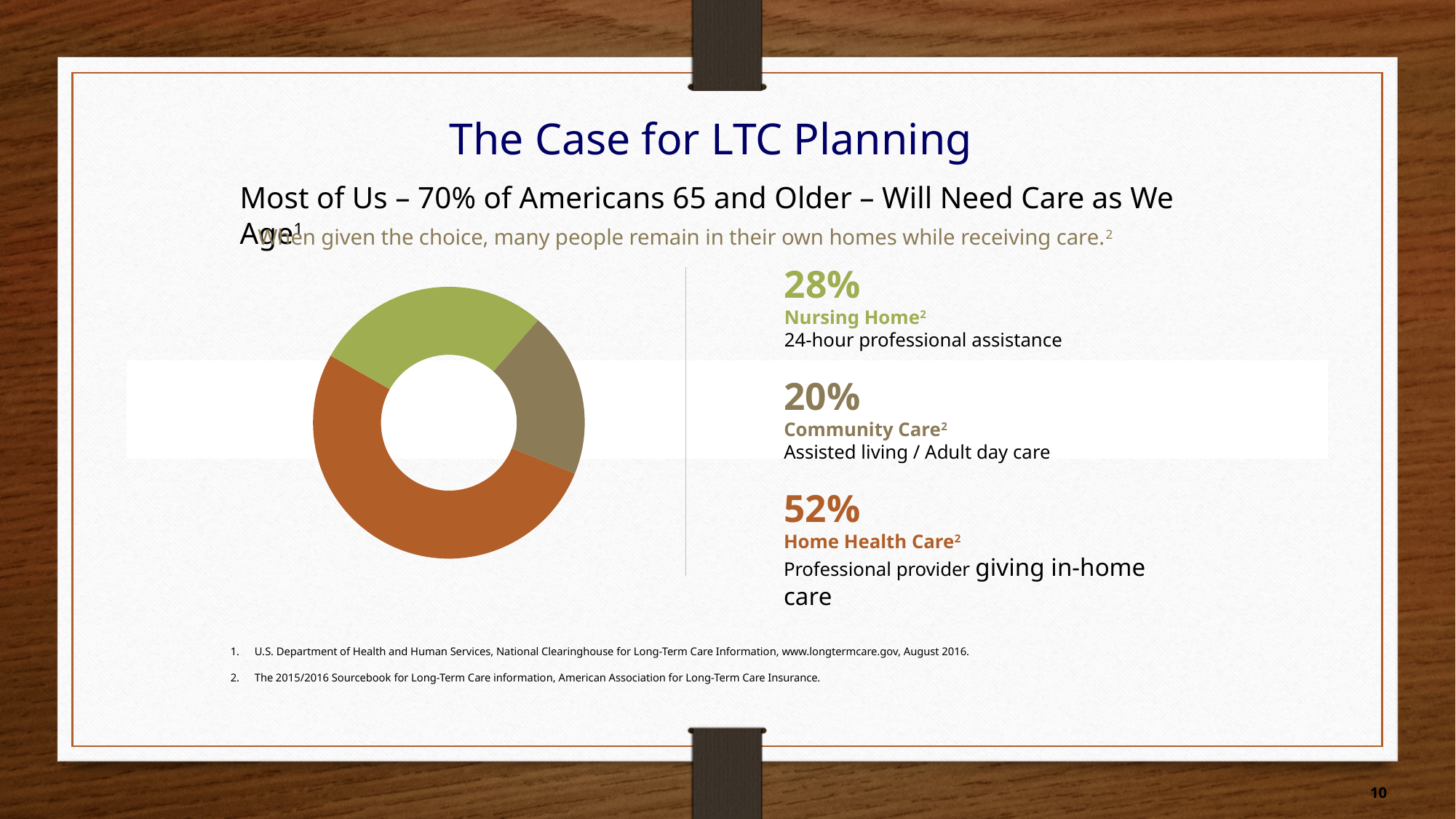
Which colour represents Home Health Care in the chart? Orange What percentage is shown for Nursing Home? 28% Which colour represents Nursing Home in the chart? Green What percentage is shown for Community Care? 20% Which category has the largest share of the chart? Home Health Care What kind of chart is shown on the slide? Doughnut (pie) chart What is the combined share of Nursing Home and Community Care? 48% What is the difference between the Home Health Care share and the Nursing Home share? 24% Which category has the smallest share of the chart? Community Care How many categories does the chart show? 3 Which is larger, the Nursing Home share or the Community Care share? Nursing Home What percentage is shown for Home Health Care? 52%